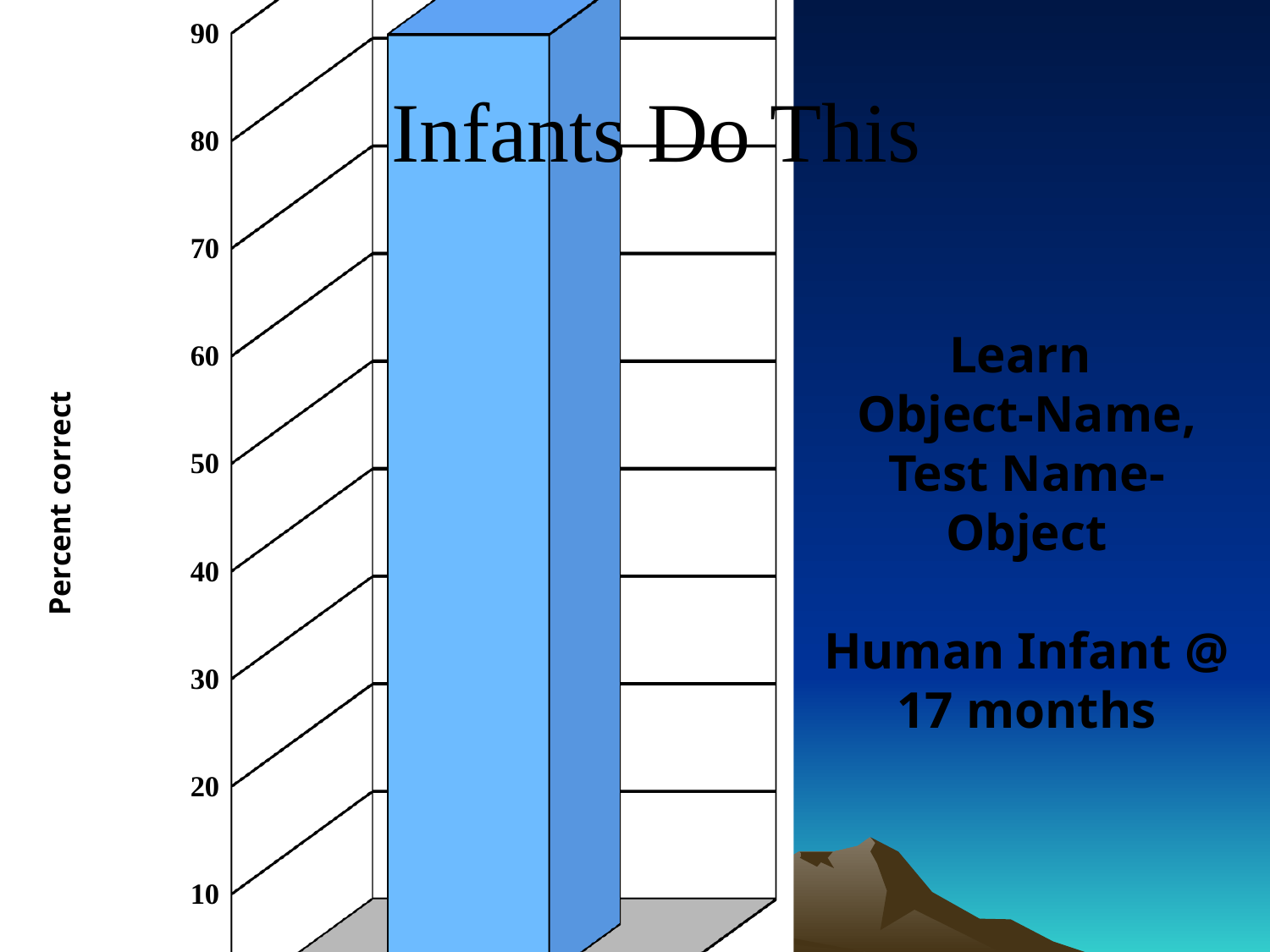
What kind of chart is shown on the slide? bar chart Is the value of the bar in the chart greater or less than 20? greater Is the value of the bar in the chart greater or less than 50? greater What is the highest tick value labelled on the vertical axis of the chart? 90 Is the value of the bar in the chart greater or less than 70? greater How many bars are plotted in the chart? 1 What is the title of the vertical axis in the chart? Percent correct